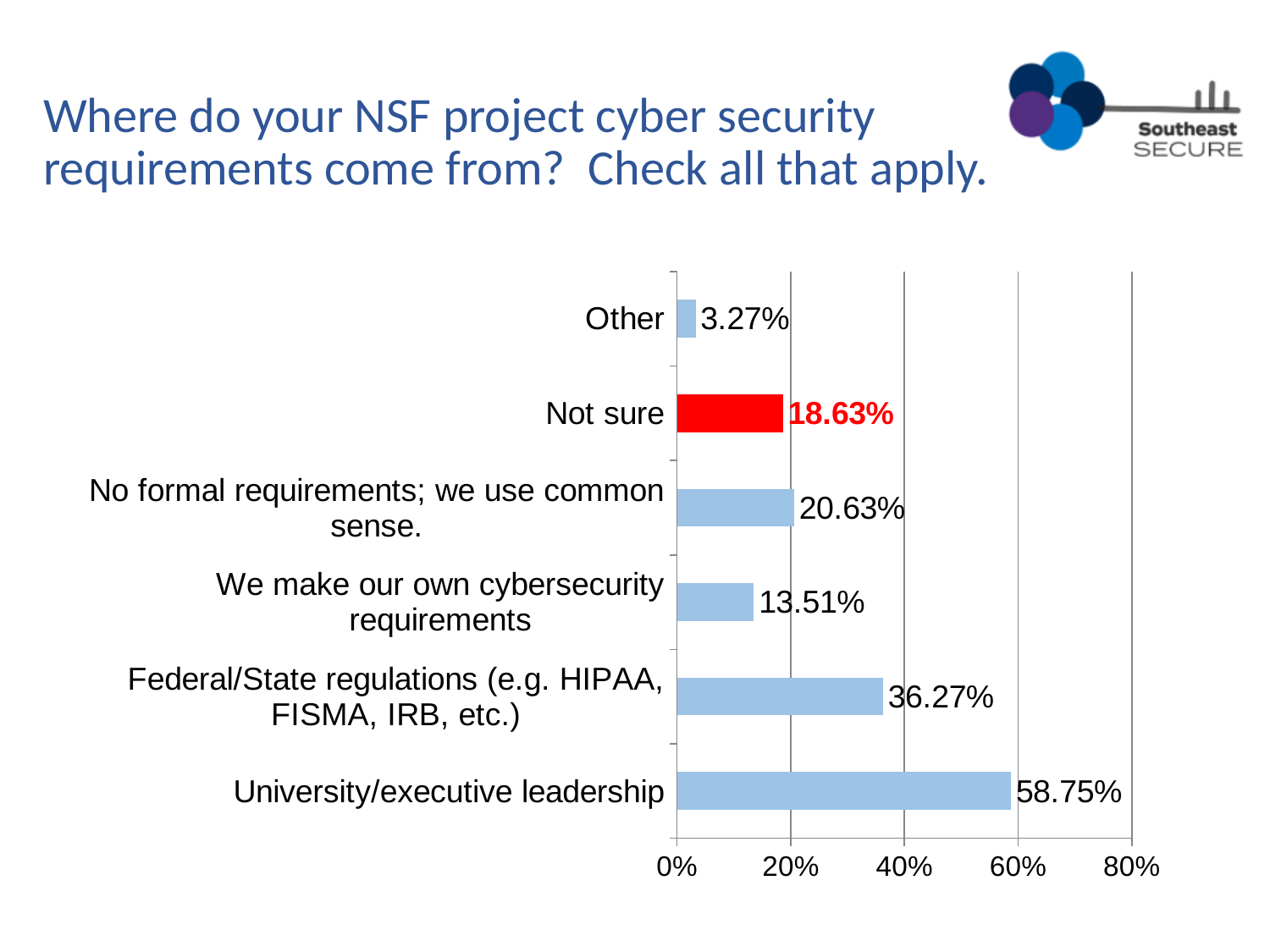
How many categories are shown in the chart? 6 What is the value for Not sure? 18.63% What is the value for Other? 3.27% What kind of chart is shown on the slide? Bar chart Which is larger: No formal requirements; we use common sense, or We make our own cybersecurity requirements? No formal requirements; we use common sense. Which category has the highest value? University/executive leadership Which bar is coloured red? Not sure Is the value for Federal/State regulations greater or less than 40%? less What percentage is shown for Federal/State regulations (e.g. HIPAA, FISMA, IRB, etc.)? 36.27% What is the difference between University/executive leadership and Federal/State regulations? 22.48% Which category has the lowest value? Other What percentage is shown for University/executive leadership? 58.75%